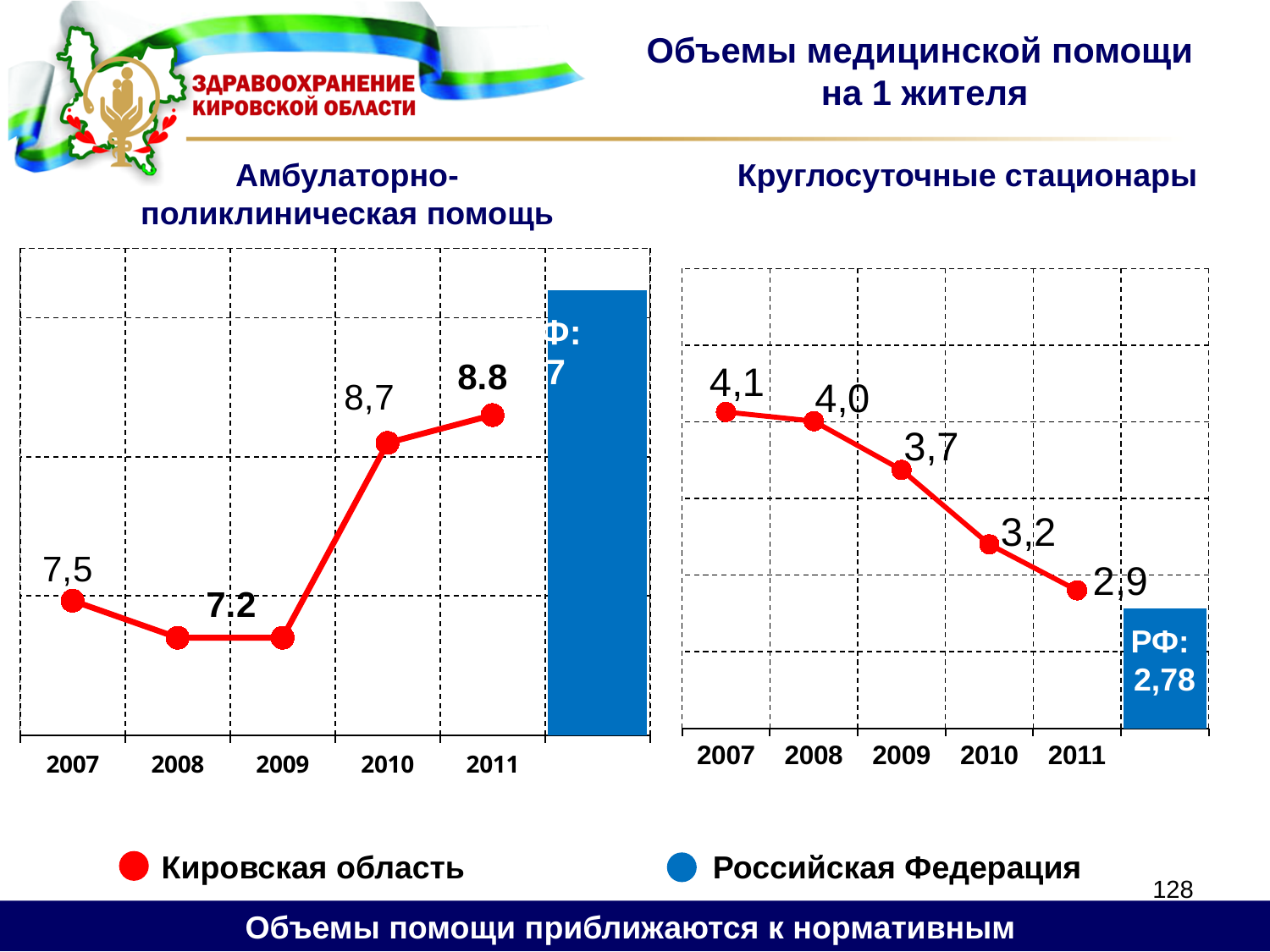
In the 'Амбулаторно-поликлиническая помощь' chart, how many years are plotted on the x axis? 5 In the 'Круглосуточные стационары' chart, what is the difference between the 2007 value and the 2011 value? 1,2 In the 'Амбулаторно-поликлиническая помощь' chart, what is the value for 2011? 8.8 In the 'Круглосуточные стационары' chart, which year has the highest value? 2007 In the 'Круглосуточные стационары' chart, which year has the lowest value? 2011 In the 'Круглосуточные стационары' chart, what is the value for 2011? 2,9 In the 'Круглосуточные стационары' chart, what is the value for 2007? 4,1 In the 'Амбулаторно-поликлиническая помощь' chart, what is the value for 2007? 7,5 According to the legend, which region do the red markers represent? Кировская область In the 'Амбулаторно-поликлиническая помощь' chart, which year has the larger value, 2007 or 2010? 2010 In the 'Круглосуточные стационары' chart, do the values rise or fall from 2007 to 2011? fall In the 'Круглосуточные стационары' chart, what value is shown for РФ (Российская Федерация)? 2,78